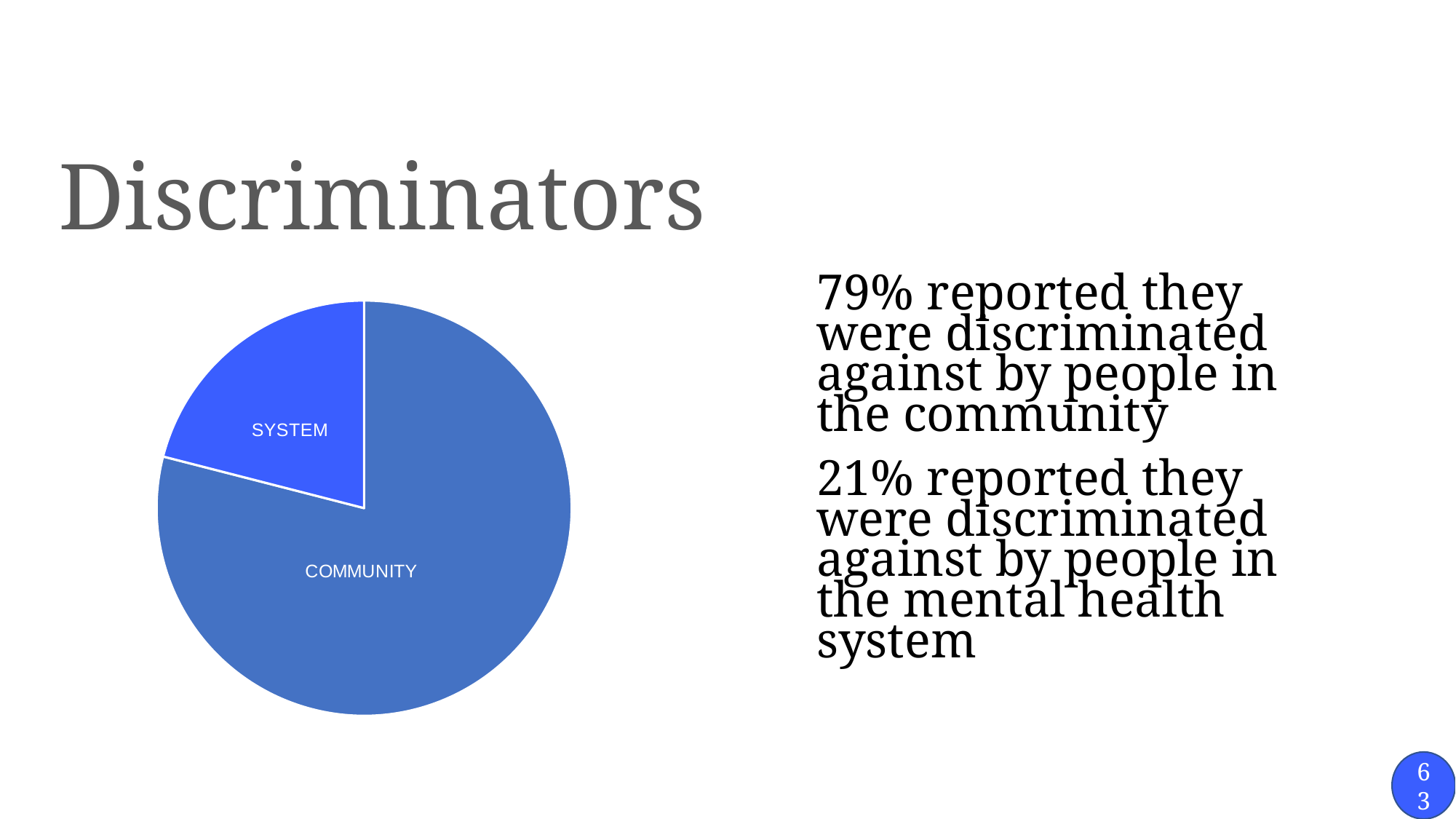
What share of the pie does the SYSTEM slice represent? 21% What is the title of the slide containing the pie chart? Discriminators Which slice is larger, COMMUNITY or SYSTEM? COMMUNITY How many slices does the pie chart have? 2 What share of the pie does the COMMUNITY slice represent? 79% By how many percentage points does the COMMUNITY share exceed the SYSTEM share? 58% Is the COMMUNITY slice greater or less than half of the pie? greater What are the labels of the two slices in the pie chart? SYSTEM and COMMUNITY What kind of chart is shown on the slide? pie chart Which slice of the pie chart is the largest? COMMUNITY Which slice of the pie chart is the smallest? SYSTEM